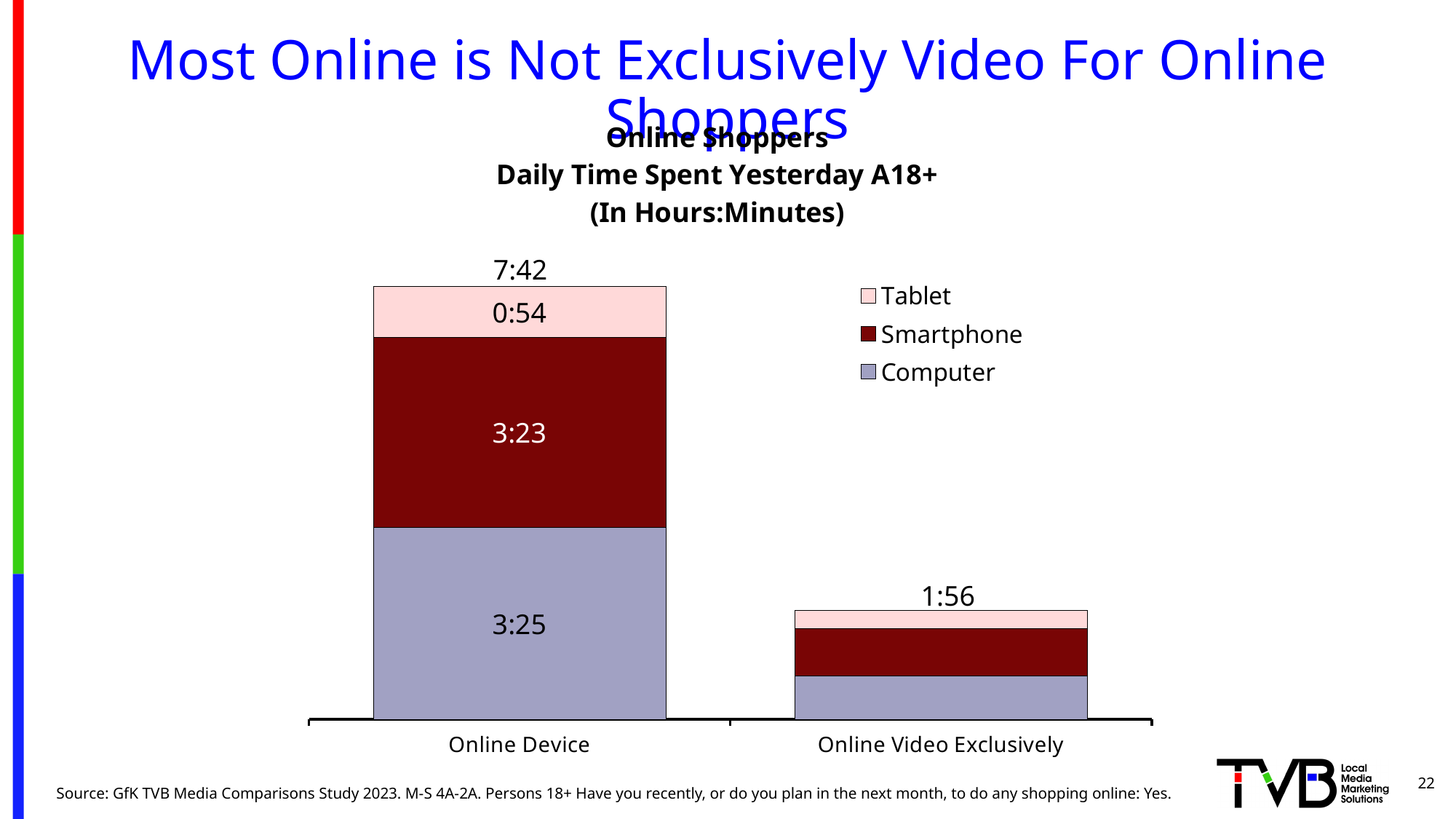
What is the total daily time spent shown for Online Device? 7:42 Within the Online Device bar, which device segment is the largest? Computer What is the difference between the Online Device total and the Online Video Exclusively total? 5:46 How many series does the legend list? 3 What is the Smartphone value for Online Device? 3:23 Which category has the larger total, Online Device or Online Video Exclusively? Online Device How many categories are shown on the x axis? 2 What is the total daily time spent shown for Online Video Exclusively? 1:56 What is the Computer value for Online Device? 3:25 Within the Online Device bar, which device segment is the smallest? Tablet What kind of chart is shown on the slide? Stacked bar chart What is the Tablet value for Online Device? 0:54